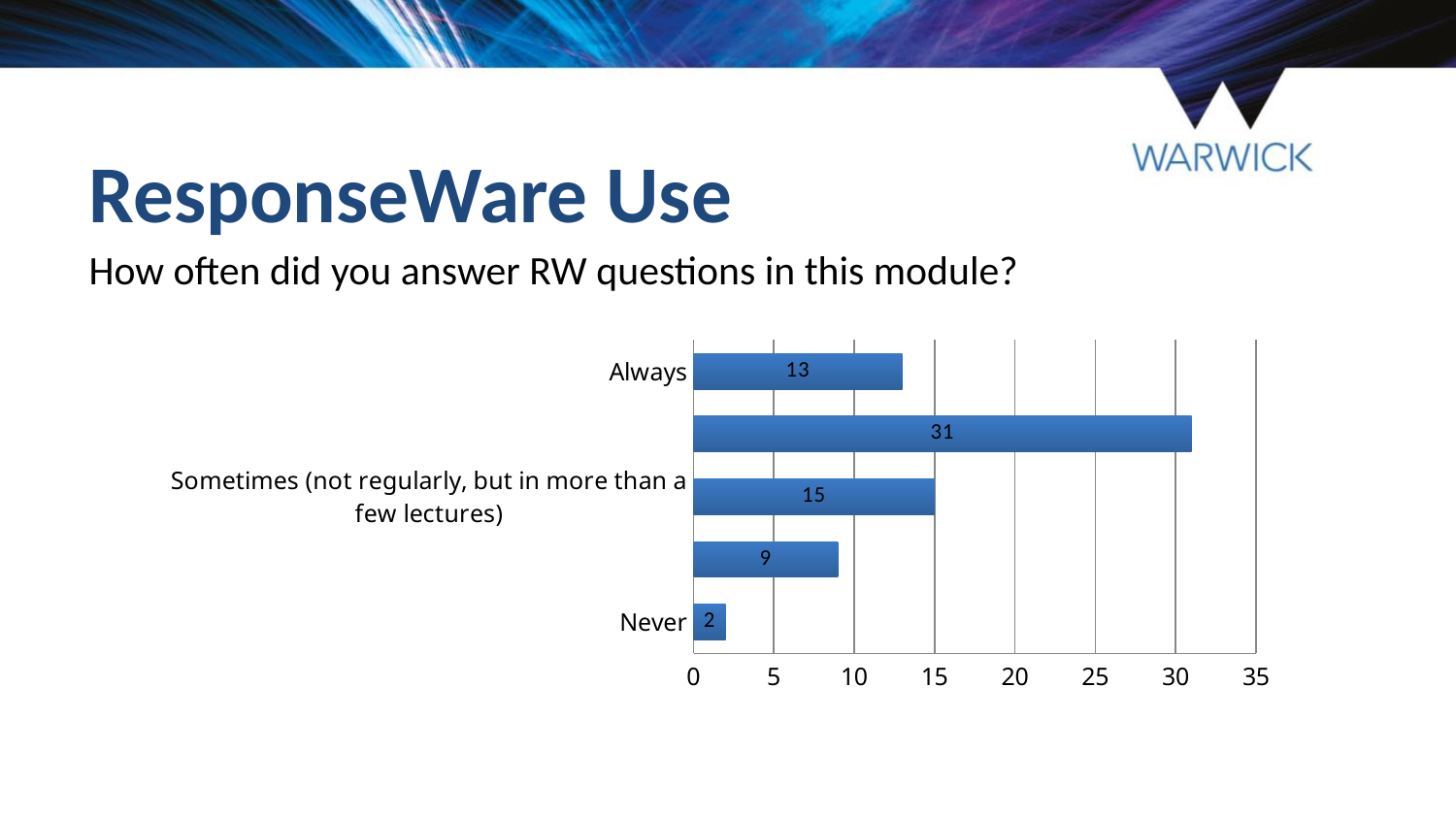
How many bars are plotted in the chart? 5 What value is shown for the "Never" bar? 2 Which labelled category has the lowest value? Never What is the difference between the values for "Sometimes (not regularly, but in more than a few lectures)" and "Always"? 2 What is the highest value shown on the horizontal axis of the chart? 35 What value is shown for the "Always" bar? 13 Which is larger, the value for "Always" or the value for "Sometimes (not regularly, but in more than a few lectures)"? Sometimes (not regularly, but in more than a few lectures) Is the value for "Always" greater or less than 10? greater What is the difference between the values for "Always" and "Never"? 11 What value is shown for the "Sometimes (not regularly, but in more than a few lectures)" bar? 15 What kind of chart is shown on the slide? Bar chart What is the largest value labelled on any bar in the chart? 31